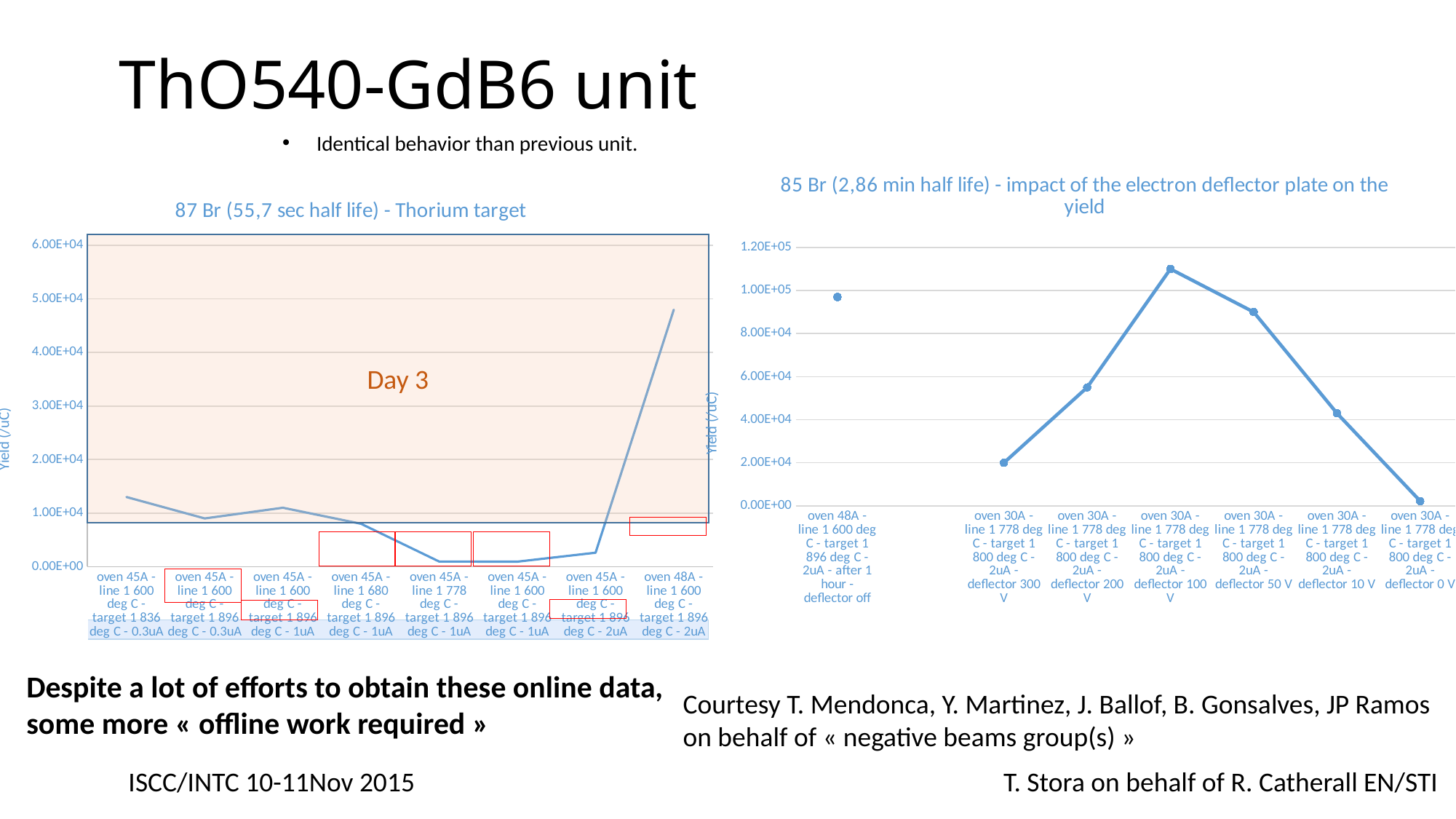
In the right chart '85 Br (2,86 min half life) - impact of the electron deflector plate on the yield', which is larger: the value for 'deflector 200 V' or the value for 'deflector 10 V'? deflector 200 V In the left chart '87 Br (55,7 sec half life) - Thorium target', is the value for 'oven 45A - line 1 600 deg C - target 1 836 deg C - 0.3uA' greater or less than 1.00E+04? greater In the right chart '85 Br (2,86 min half life) - impact of the electron deflector plate on the yield', which category has the lowest yield? oven 30A - line 1 778 deg C - target 1 800 deg C - 2uA - deflector 0 V What text annotation is written inside the shaded area of the left chart? Day 3 In the right chart '85 Br (2,86 min half life) - impact of the electron deflector plate on the yield', which category has the highest yield? oven 30A - line 1 778 deg C - target 1 800 deg C - 2uA - deflector 100 V How many categories are plotted on the x axis of the left chart '87 Br (55,7 sec half life) - Thorium target'? 8 How many data points are plotted in the right chart '85 Br (2,86 min half life) - impact of the electron deflector plate on the yield'? 7 In the left chart '87 Br (55,7 sec half life) - Thorium target', is the value for 'oven 48A - line 1 600 deg C - target 1 896 deg C - 2uA' greater or less than 4.00E+04? greater In the right chart '85 Br (2,86 min half life) - impact of the electron deflector plate on the yield', is the value for 'deflector 100 V' greater or less than 1.00E+05? greater In the left chart '87 Br (55,7 sec half life) - Thorium target', which category has the highest yield? oven 48A - line 1 600 deg C - target 1 896 deg C - 2uA What kind of chart is the left chart titled '87 Br (55,7 sec half life) - Thorium target'? line chart